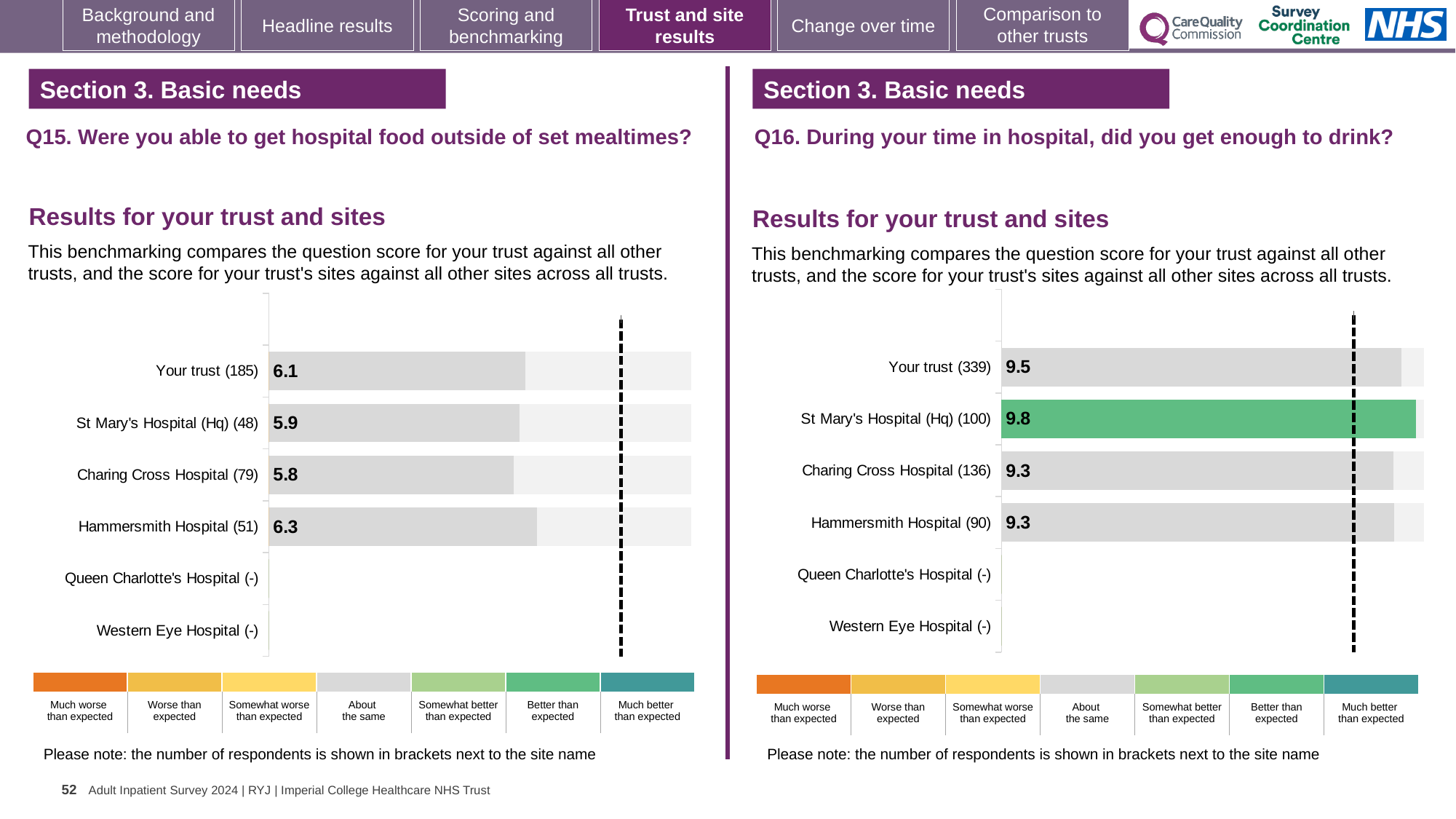
What kind of chart is used on the Q15 chart (left)? Bar chart On the Q15 chart (left), which site has the highest score? Hammersmith Hospital (51) On the Q16 chart (right), which benchmark category does the green bar for St Mary's Hospital (Hq) (100) indicate? Better than expected On the Q16 chart (right), what is the score for Your trust (339)? 9.5 On the Q15 chart (left), what is the score for Charing Cross Hospital (79)? 5.8 On the Q16 chart (right), which site has the highest score? St Mary's Hospital (Hq) (100) On the Q15 chart (left), what is the score for Your trust (185)? 6.1 On the Q16 chart (right), what is the difference between the scores for St Mary's Hospital (Hq) (100) and Charing Cross Hospital (136)? 0.5 On the Q15 chart (left), which site has the lowest score? Charing Cross Hospital (79) On the Q16 chart (right), which has the larger score, Your trust (339) or Hammersmith Hospital (90)? Your trust (339) On the Q16 chart (right), what is the score for St Mary's Hospital (Hq) (100)? 9.8 On the Q15 chart (left), what is the difference between the scores for Hammersmith Hospital (51) and St Mary's Hospital (Hq) (48)? 0.4